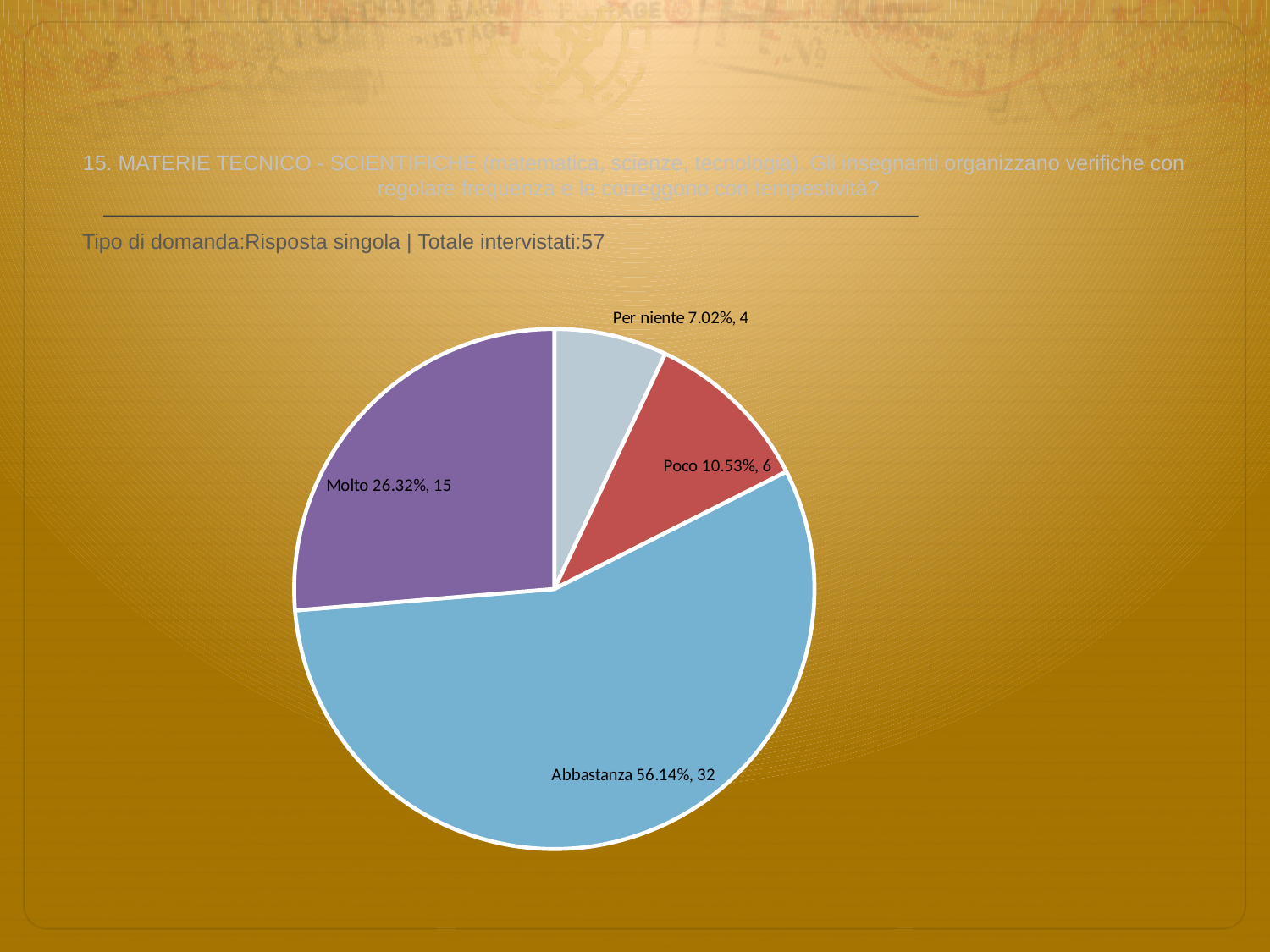
What colour is the 'Molto' slice? purple What is the difference in respondent count between 'Abbastanza' and 'Molto'? 17 What kind of chart is shown on the slide? pie chart What percentage share does the 'Per niente' slice have? 7.02% What is the total number of respondents across all slices? 57 Which category has the smallest slice? Per niente How many slices does the pie chart have? 4 What percentage share does the 'Abbastanza' slice have? 56.14% Which has more respondents, 'Poco' or 'Per niente'? Poco Which category has the largest slice? Abbastanza How many respondents answered 'Poco'? 6 How many respondents answered 'Molto'? 15